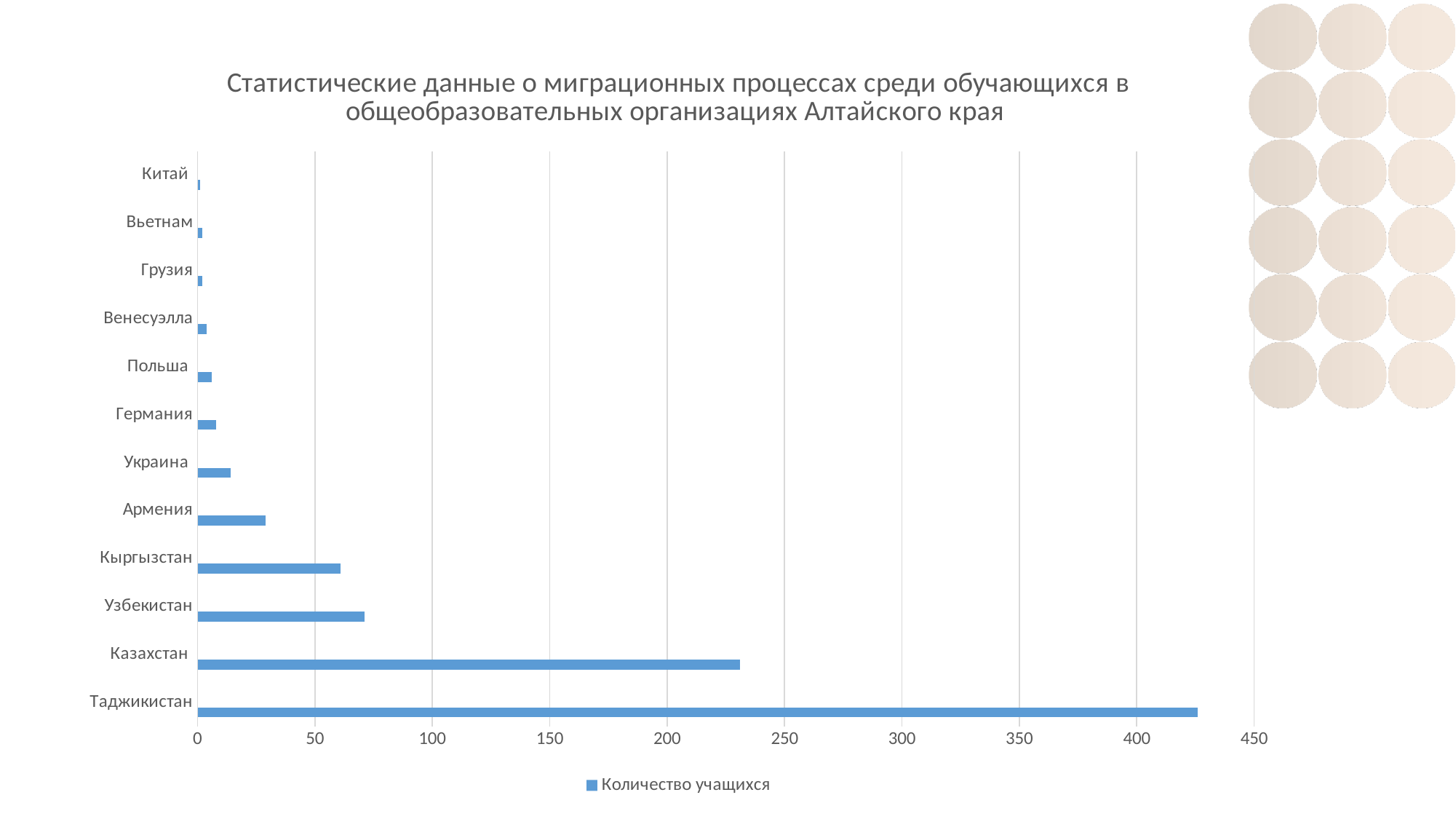
What kind of chart is shown on the slide? bar chart Which country has the highest number of students on the chart? Таджикистан Which country has the lowest number of students on the chart? Китай Is the value for Узбекистан greater or less than 100? less Is the value for Казахстан greater or less than 200? greater Is the value for Таджикистан greater or less than 400? greater Which has a larger value, Казахстан or Узбекистан? Казахстан What is the name of the series shown in the legend? Количество учащихся How many series does the legend list? 1 How many countries are listed on the chart? 12